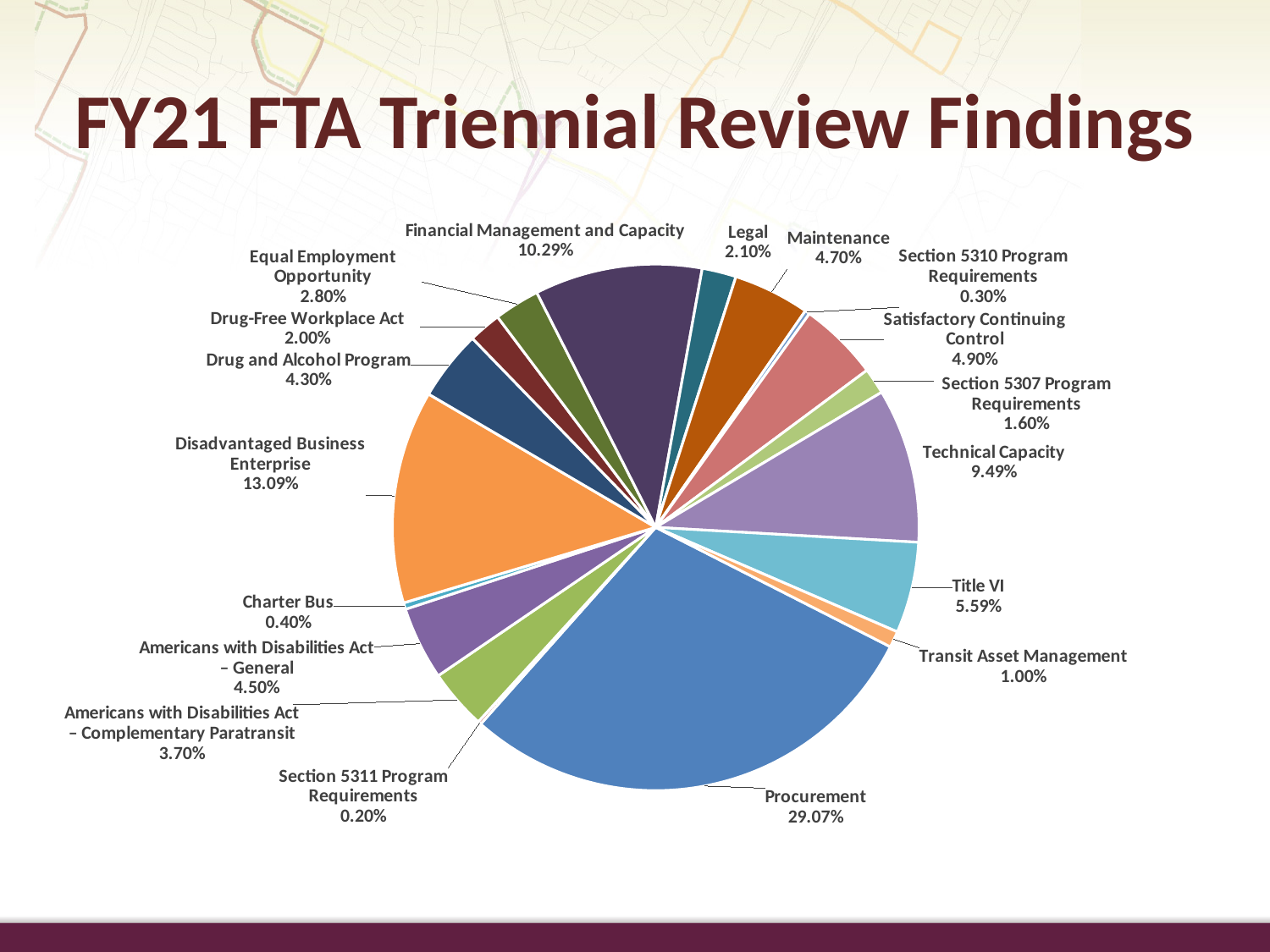
What is the value shown for Disadvantaged Business Enterprise? 13.09% What share of the pie does Procurement represent? 29.07% What is the difference between the Title VI share and the Maintenance share? 0.89% Which category has the largest share of the pie? Procurement What is the difference between the Procurement share and the Disadvantaged Business Enterprise share? 15.98% What is the value shown for Technical Capacity? 9.49% What is the title of the slide containing the pie chart? FY21 FTA Triennial Review Findings How many categories are shown in the pie chart? 18 What is the value shown for Drug and Alcohol Program? 4.30% Which is larger, Financial Management and Capacity or Technical Capacity? Financial Management and Capacity Which category has the smallest share of the pie? Section 5311 Program Requirements What type of chart is shown on the slide? pie chart